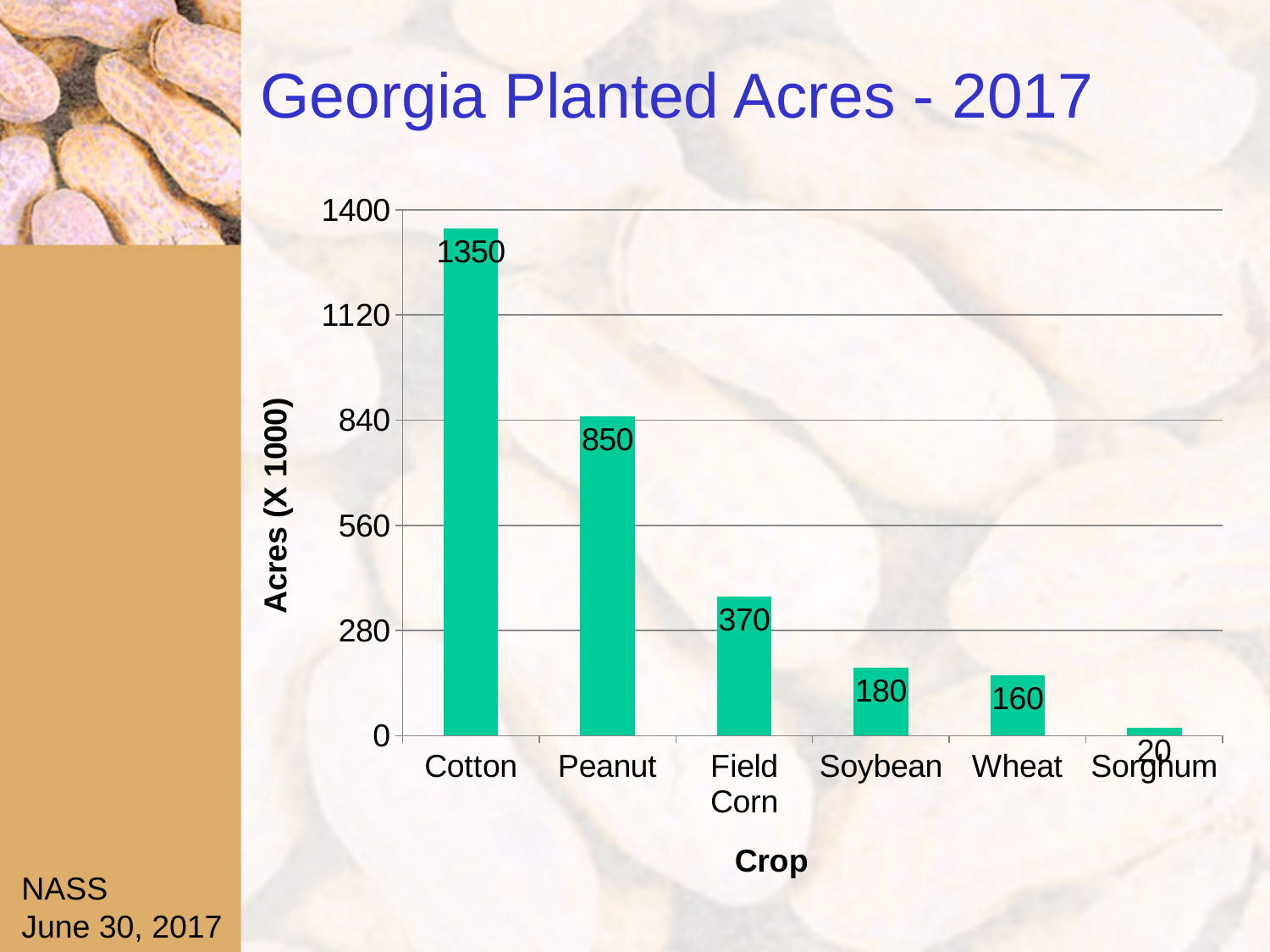
Which crop has the highest planted acres? Cotton What is the difference between the values for Soybean and Wheat? 20 Which has a larger value, Field Corn or Soybean? Field Corn What kind of chart is shown on the slide? Bar chart What is the value shown for Wheat? 160 What is the difference between the values for Cotton and Peanut? 500 What is the planted acreage value shown for Peanut? 850 How many crops are shown on the x axis? 6 What is the value shown for Field Corn? 370 What is the label of the y axis? Acres (X 1000) Which crop has the lowest planted acres? Sorghum What is the planted acreage value shown for Cotton? 1350